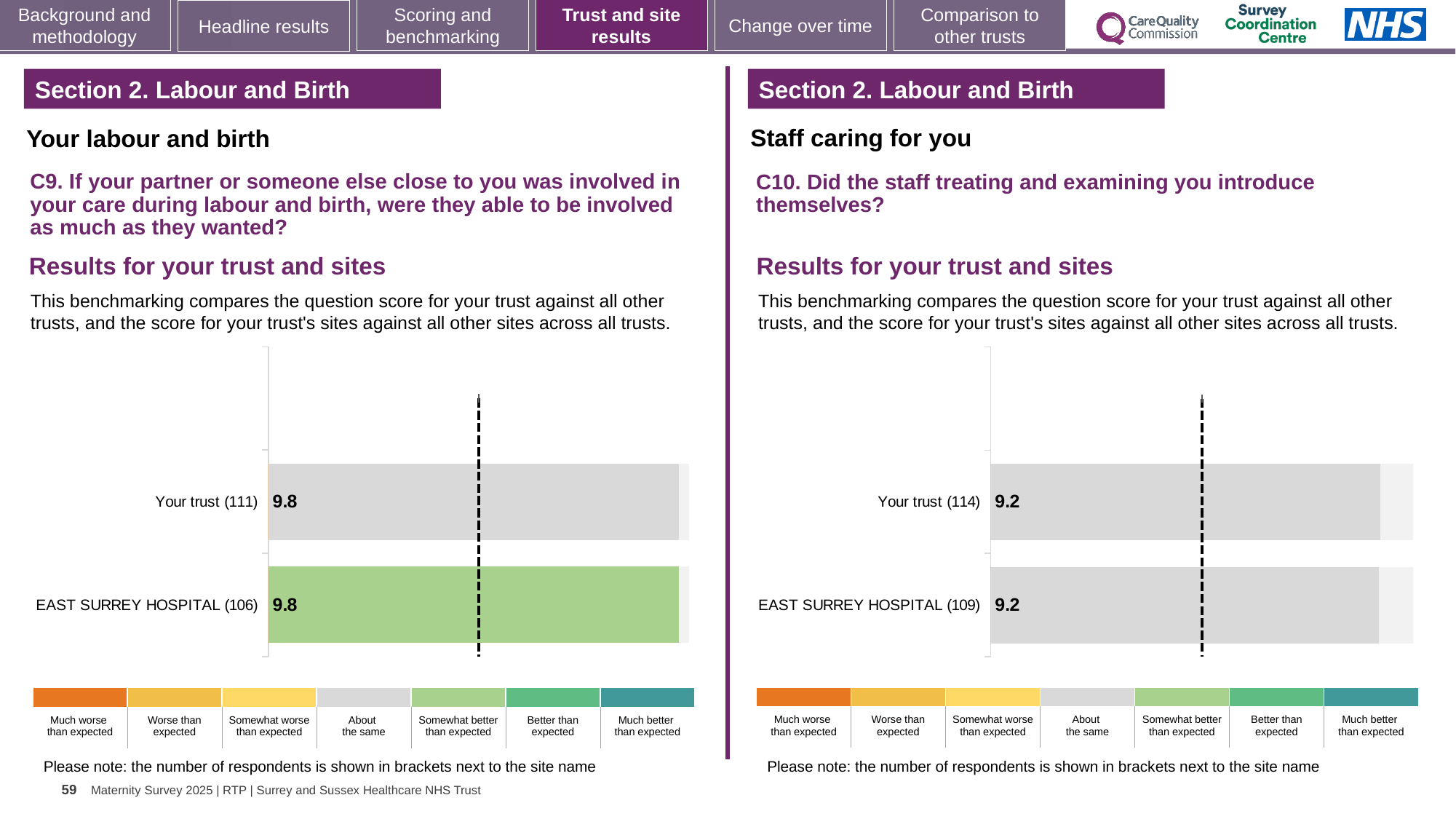
On the C9 chart (left), what is the score for Your trust? 9.8 On the C10 chart (right), what is the difference between the Your trust score and the EAST SURREY HOSPITAL score? 0.0 On the C10 chart (right), what is the score for EAST SURREY HOSPITAL? 9.2 On the C9 chart (left), what is the score for EAST SURREY HOSPITAL? 9.8 On the C9 chart (left), what is the difference between the Your trust score and the EAST SURREY HOSPITAL score? 0.0 How many bars are plotted on the C9 chart (left)? 2 How many bars are plotted on the C10 chart (right)? 2 On the C10 chart (right), how many respondents are shown in brackets for Your trust? 114 On the C10 chart (right), what is the score for Your trust? 9.2 What type of chart is used on the C9 chart (left)? Bar chart Is the Your trust score on the C9 chart (left) larger than the Your trust score on the C10 chart (right)? Yes On the C9 chart (left), how many respondents are shown in brackets for EAST SURREY HOSPITAL? 106